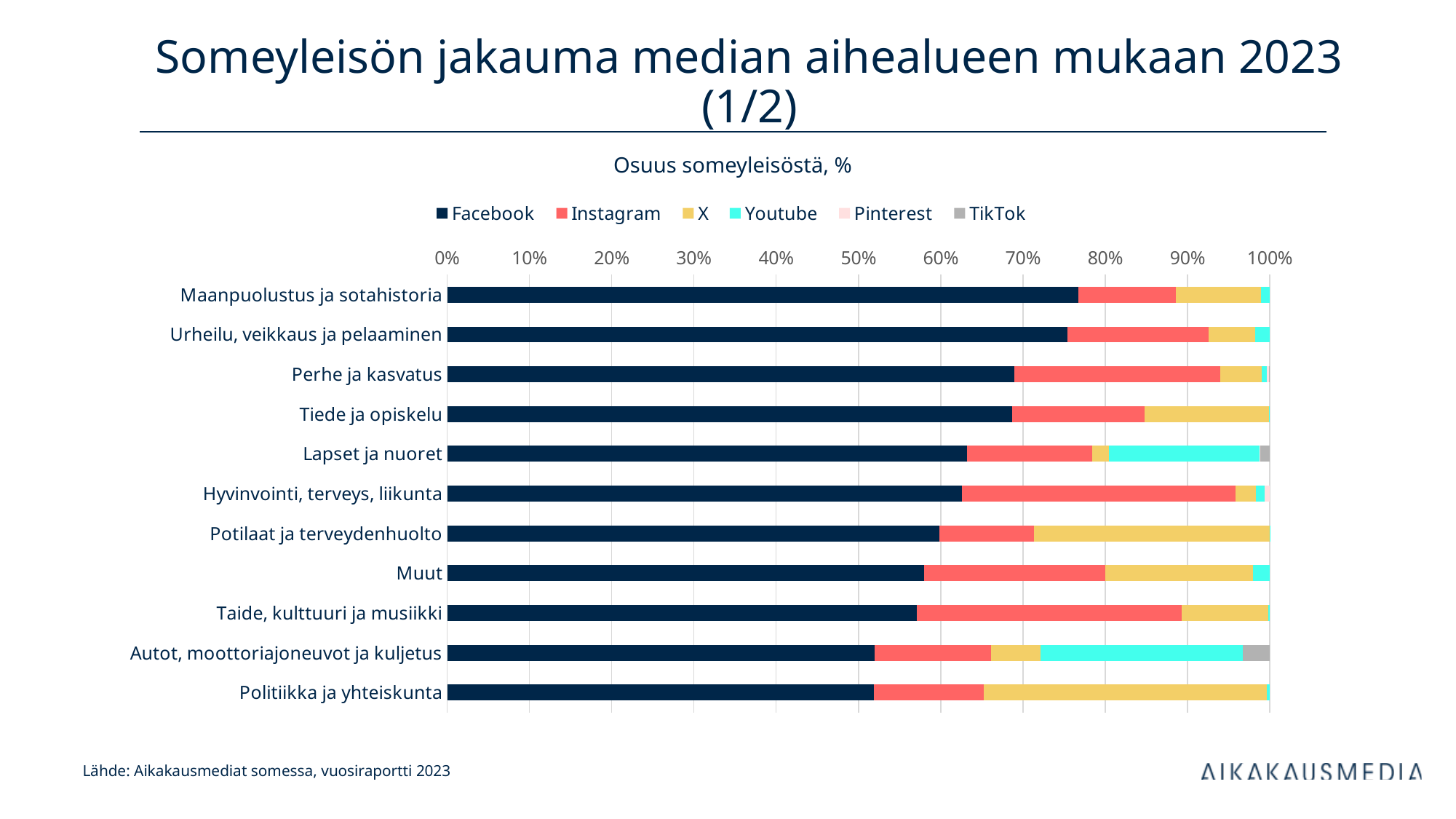
Is the Facebook share for Muut greater or less than 60%? less Which series is shown in dark navy blue? Facebook Which category has the largest Youtube share? Autot, moottoriajoneuvot ja kuljetus Is the Facebook share for Lapset ja nuoret greater or less than 60%? greater How many media topic categories are listed on the chart? 11 Is the Facebook share for Autot, moottoriajoneuvot ja kuljetus greater or less than 50%? greater What kind of chart is shown on the slide? Stacked bar chart Which category has the largest X share? Politiikka ja yhteiskunta Which has the larger Facebook share: Maanpuolustus ja sotahistoria or Politiikka ja yhteiskunta? Maanpuolustus ja sotahistoria What is the title of the chart? Osuus someyleisöstä, % How many series does the legend list? 6